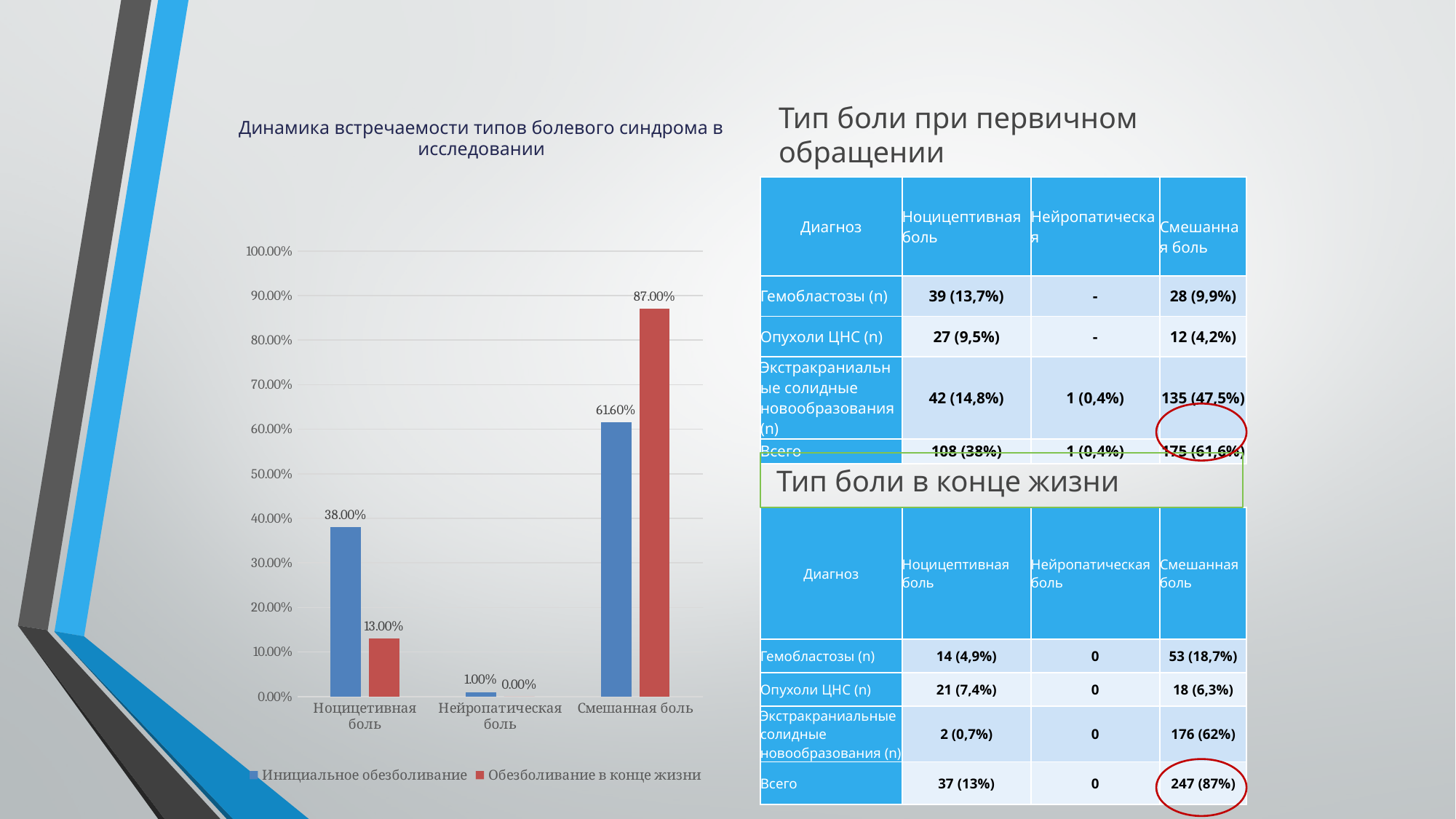
What is the value for Смешанная боль in the Инициальное обезболивание series? 61.60% What type of chart is shown on the slide? bar chart What is the value for Ноцицетивная боль in the Обезболивание в конце жизни series? 13.00% Which category has the lowest value in the Инициальное обезболивание series? Нейропатическая боль What is the value for Ноцицетивная боль in the Инициальное обезболивание series? 38.00% For Ноцицетивная боль, which series has the larger value: Инициальное обезболивание or Обезболивание в конце жизни? Инициальное обезболивание What is the value for Смешанная боль in the Обезболивание в конце жизни series? 87.00% Which category has the highest value in the Обезболивание в конце жизни series? Смешанная боль What is the value for Нейропатическая боль in the Инициальное обезболивание series? 1.00% How many series does the chart legend list? 2 What is the difference between the Обезболивание в конце жизни and Инициальное обезболивание values for Смешанная боль? 25.40% How many categories are shown on the x axis of the chart? 3